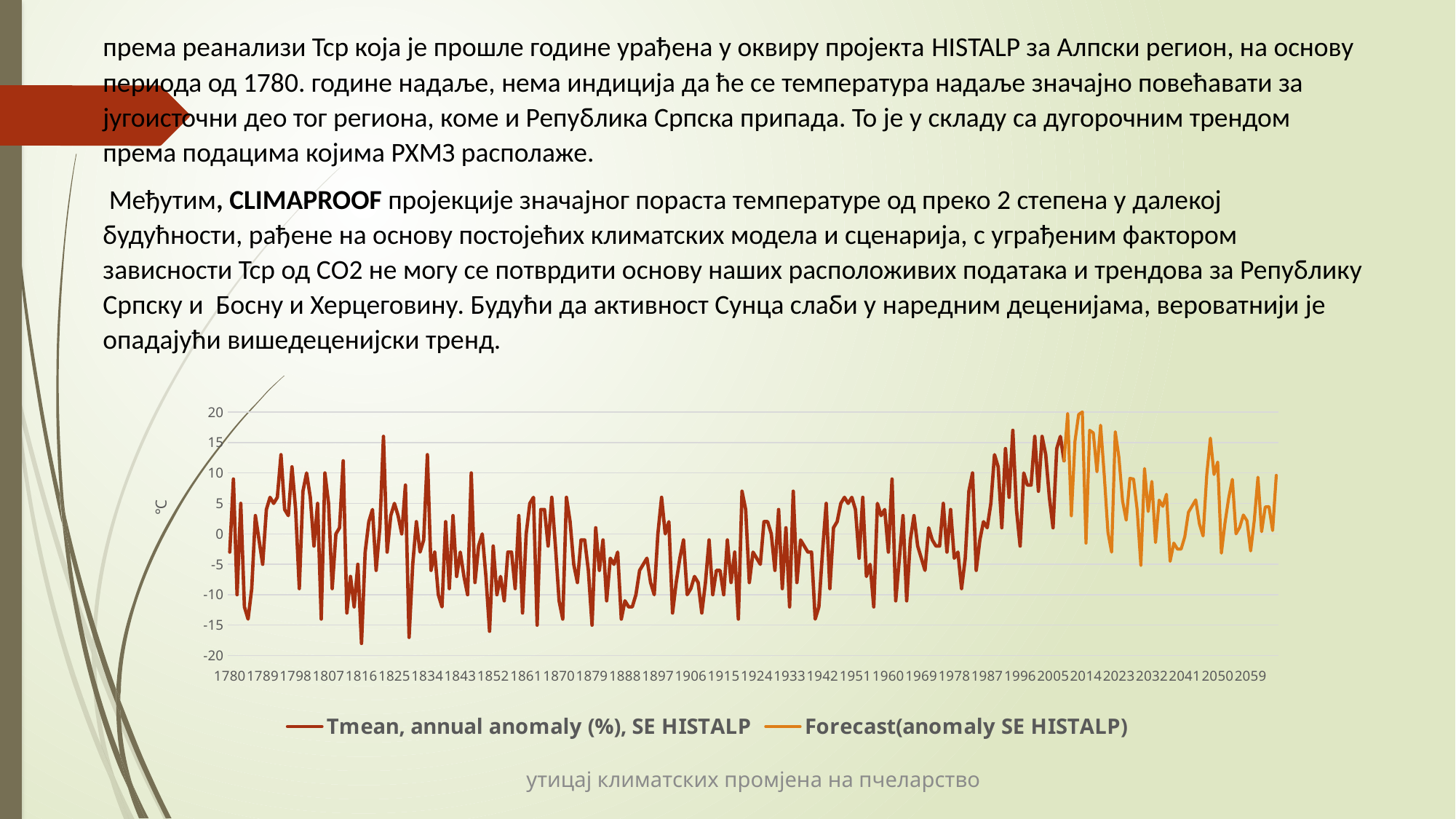
Which series is drawn in orange on the chart? Forecast(anomaly SE HISTALP) How many series does the chart legend list? 2 Does the Tmean, annual anomaly (%), SE HISTALP series generally rise or fall from around 1960 to 2005? rise What is the label on the vertical axis of the chart? °C What kind of chart is shown on the slide? line chart Does the Forecast(anomaly SE HISTALP) series generally rise or fall from around 2014 to 2059? fall